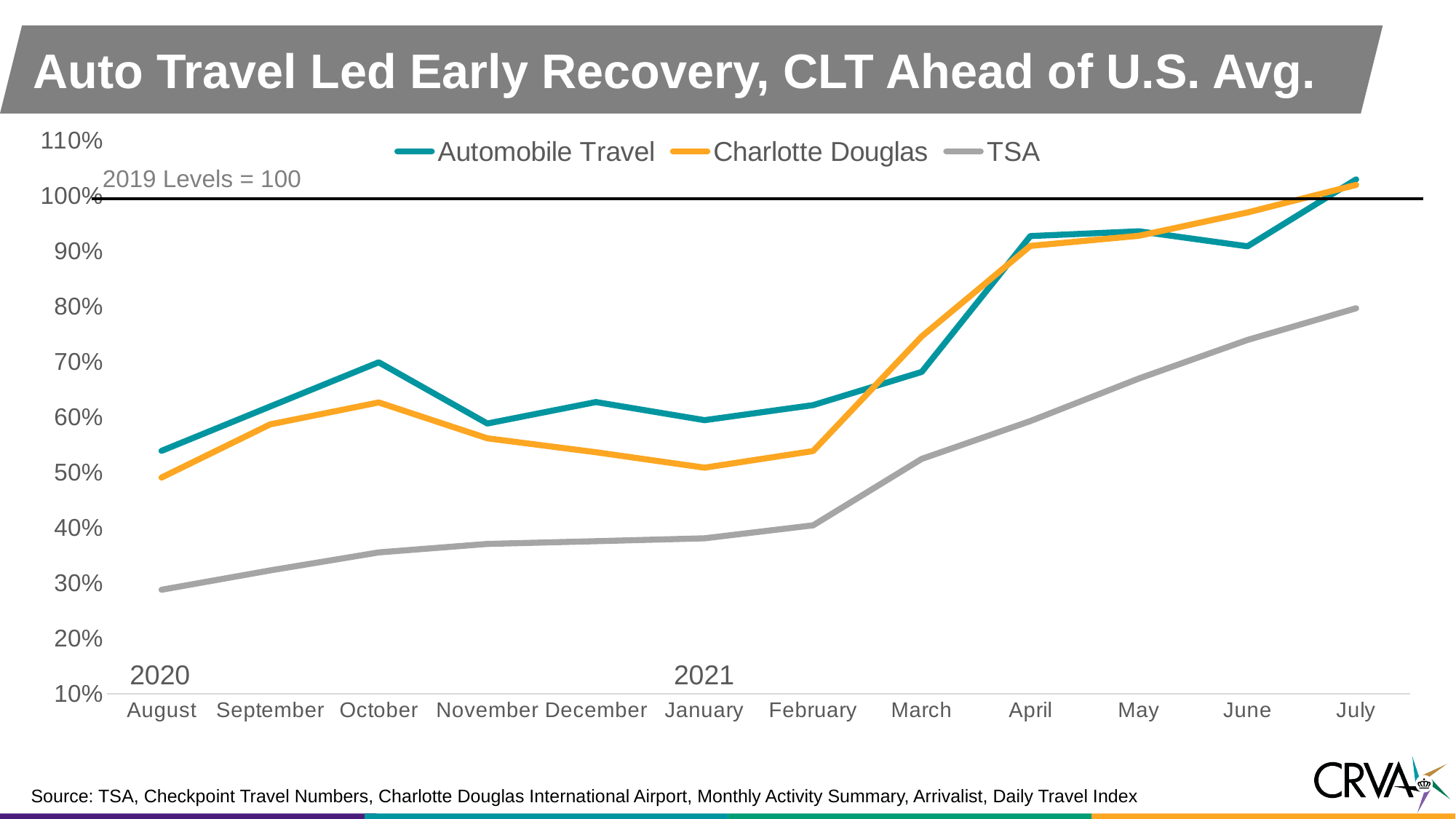
How many series does the legend list? 3 How many months are plotted along the x axis? 12 Does the TSA series generally rise or fall from August to July? Rise In which month is the Automobile Travel series at its highest? July Is the value for Charlotte Douglas in July greater or less than 100%? greater In October, which series has the higher value: Automobile Travel or TSA? Automobile Travel Is the value for Charlotte Douglas in November greater or less than 60%? less Is the value for TSA in December greater or less than 40%? less What kind of chart is shown on the slide? Line chart In which month is the TSA series at its lowest? August In January, which series has the higher value: Automobile Travel or Charlotte Douglas? Automobile Travel